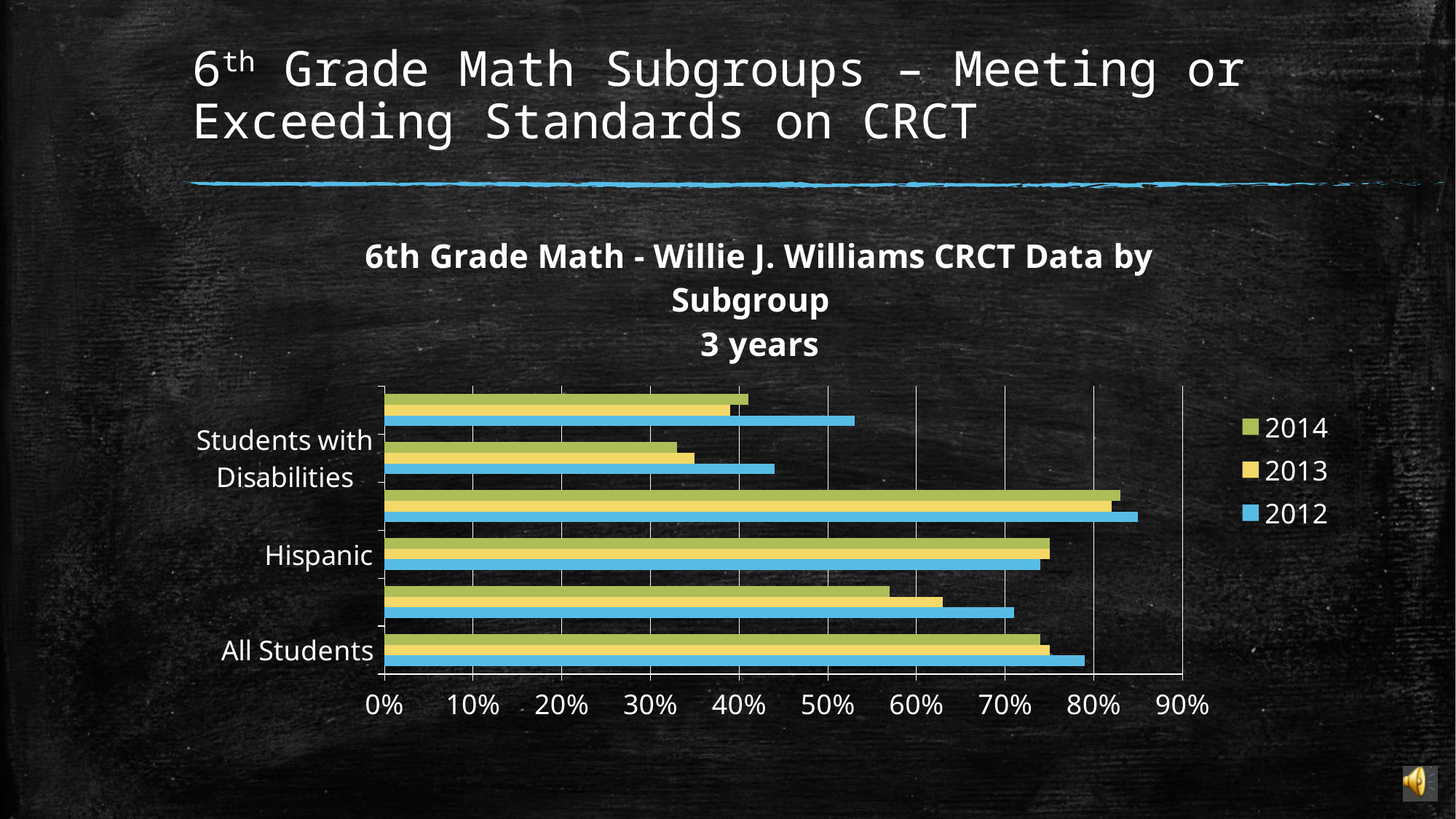
What is the title of the chart? 6th Grade Math - Willie J. Williams CRCT Data by Subgroup 3 years How many series does the legend list? 3 What kind of chart is shown on the slide? Bar chart Is the 2012 value for Hispanic greater or less than 70%? greater For All Students, which year has the higher value: 2012 or 2014? 2012 Is the 2012 value for Students with Disabilities greater or less than 50%? less Is the 2012 value for Students with Disabilities greater or less than 40%? greater Which years are listed in the chart's legend? 2014, 2013, 2012 For Students with Disabilities, which year has the higher value: 2012 or 2014? 2012